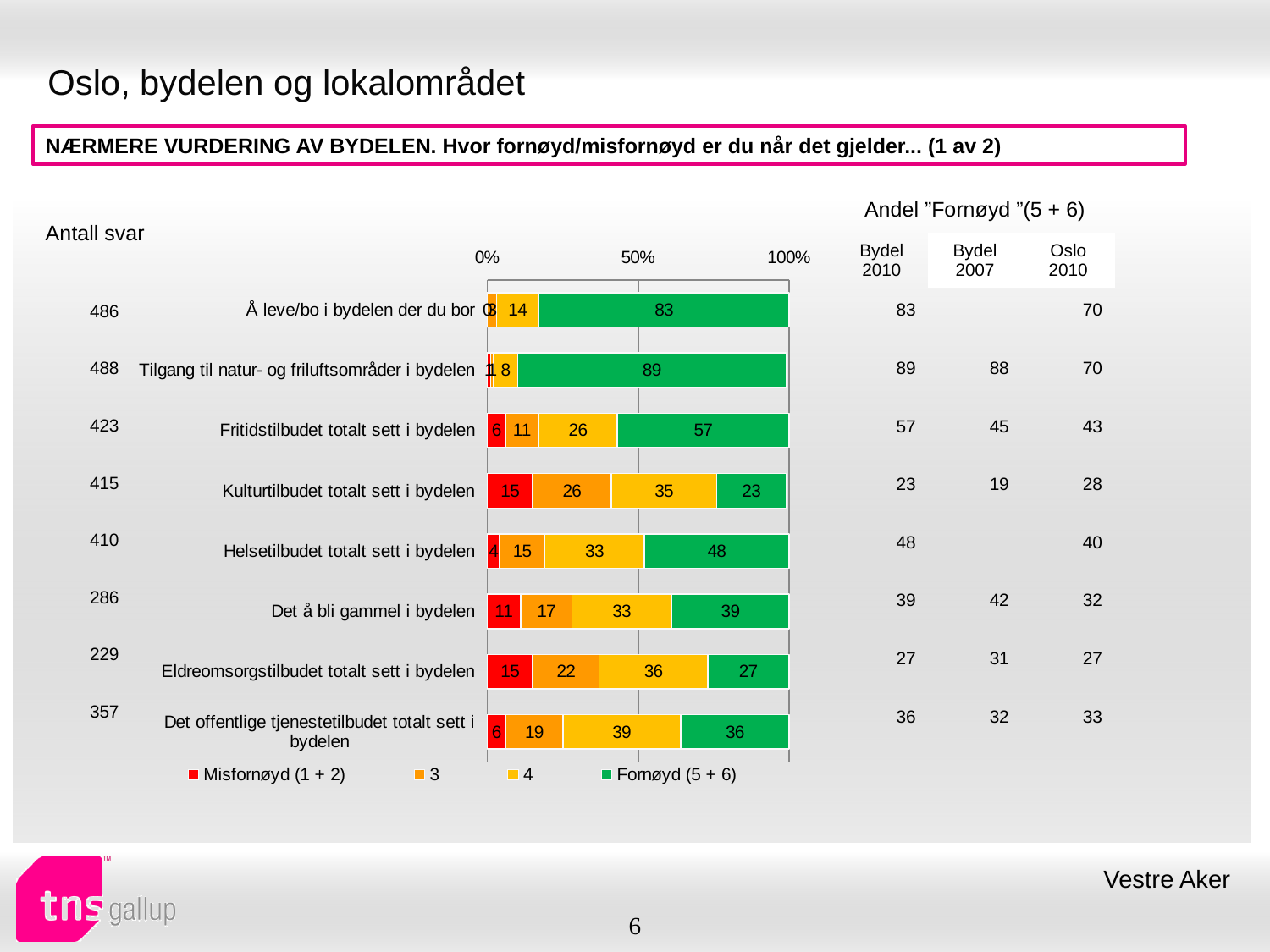
What is the difference between the "Fornøyd (5 + 6)" values for "Helsetilbudet totalt sett i bydelen" and "Det å bli gammel i bydelen"? 9 Which category has the highest "Fornøyd (5 + 6)" value? Tilgang til natur- og friluftsområder i bydelen Which has the larger "Fornøyd (5 + 6)" value: "Eldreomsorgstilbudet totalt sett i bydelen" or "Det offentlige tjenestetilbudet totalt sett i bydelen"? Det offentlige tjenestetilbudet totalt sett i bydelen What is the value of the "Misfornøyd (1 + 2)" segment for "Kulturtilbudet totalt sett i bydelen"? 15 Which category has the lowest "Fornøyd (5 + 6)" value? Kulturtilbudet totalt sett i bydelen How many series does the legend list? 4 What is the first entry in the chart's legend? Misfornøyd (1 + 2) What kind of chart is shown on the slide? Stacked bar chart How many categories are plotted in the chart? 8 What is the value of the "3" segment for "Det å bli gammel i bydelen"? 17 What is the value of the "Fornøyd (5 + 6)" segment for "Fritidstilbudet totalt sett i bydelen"? 57 What is the value of the "4" segment for "Det offentlige tjenestetilbudet totalt sett i bydelen"? 39